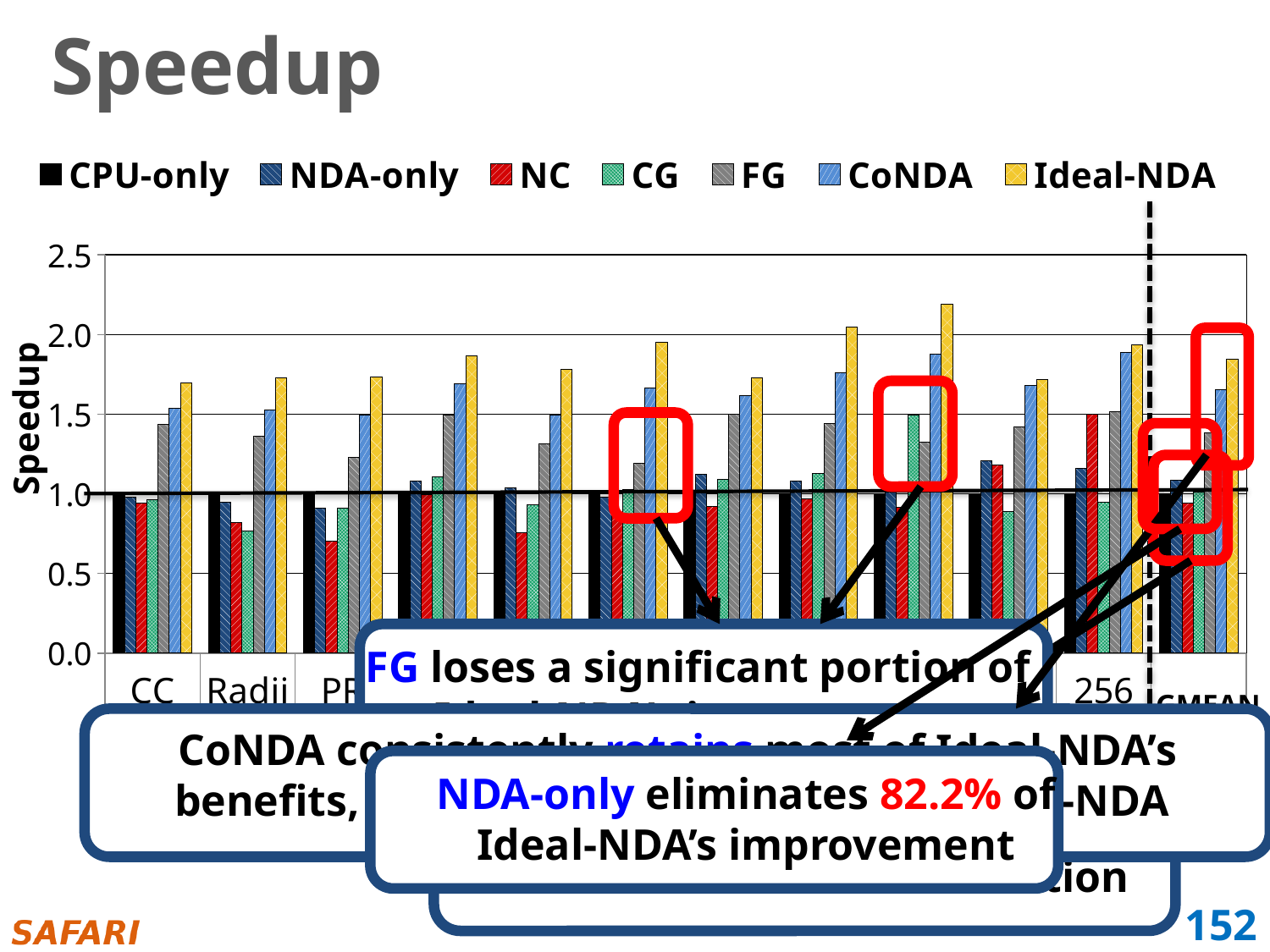
How many series does the legend list? 7 For Radii, which is larger: the Ideal-NDA value or the CG value? Ideal-NDA Is the Ideal-NDA value for GMEAN greater or less than 1.5? greater Is the Ideal-NDA value for Radii greater or less than 1.5? greater Is the CG value for Radii greater or less than 1.0? less Which series has the highest speedup for CC? Ideal-NDA What kind of chart is shown on the slide? bar chart Which series is listed first in the legend? CPU-only Which series has the highest speedup for GMEAN? Ideal-NDA What is the label on the vertical axis of the chart? Speedup